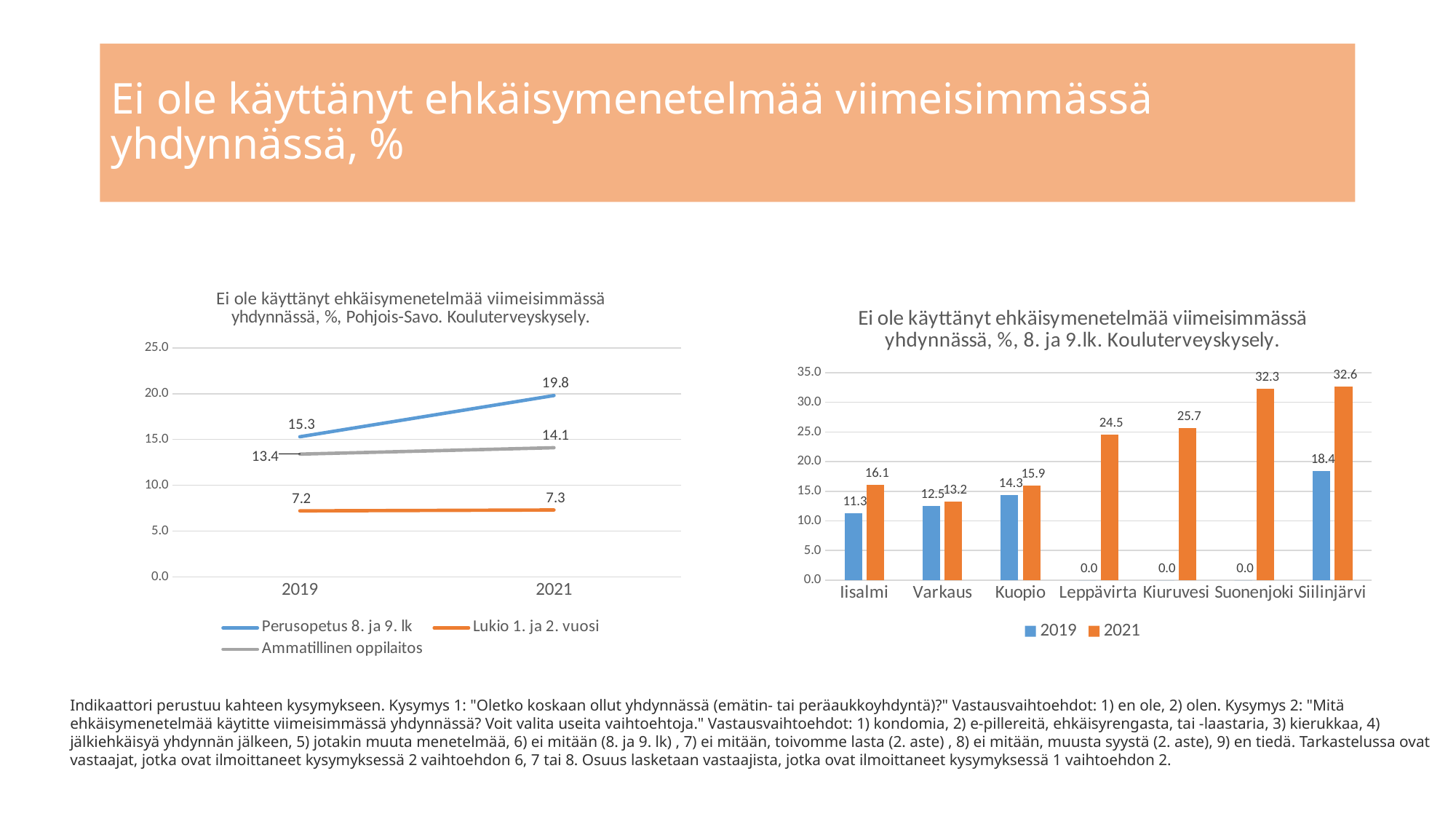
In the right chart (8. ja 9.lk), what is the 2021 value for Suonenjoki? 32.3 What kind of chart is the left chart (Pohjois-Savo)? line chart In the right chart (8. ja 9.lk), which is larger for Kuopio: the 2019 value or the 2021 value? 2021 In the right chart (8. ja 9.lk), what is the difference between the 2021 and 2019 values for Siilinjärvi? 14.2 In the right chart (8. ja 9.lk), how many municipalities are shown on the x axis? 7 In the left chart (Pohjois-Savo), what is the value for Lukio 1. ja 2. vuosi in 2019? 7.2 In the right chart (8. ja 9.lk), which municipality has the highest 2021 value? Siilinjärvi In the left chart (Pohjois-Savo), by how much did the Perusopetus 8. ja 9. lk value change from 2019 to 2021? 4.5 In the left chart (Pohjois-Savo), does the Ammatillinen oppilaitos line rise or fall from 2019 to 2021? rise In the left chart (Pohjois-Savo), how many series does the legend list? 3 In the left chart (Pohjois-Savo), what is the value for Perusopetus 8. ja 9. lk in 2021? 19.8 In the right chart (8. ja 9.lk), which municipality has the lowest 2021 value? Varkaus